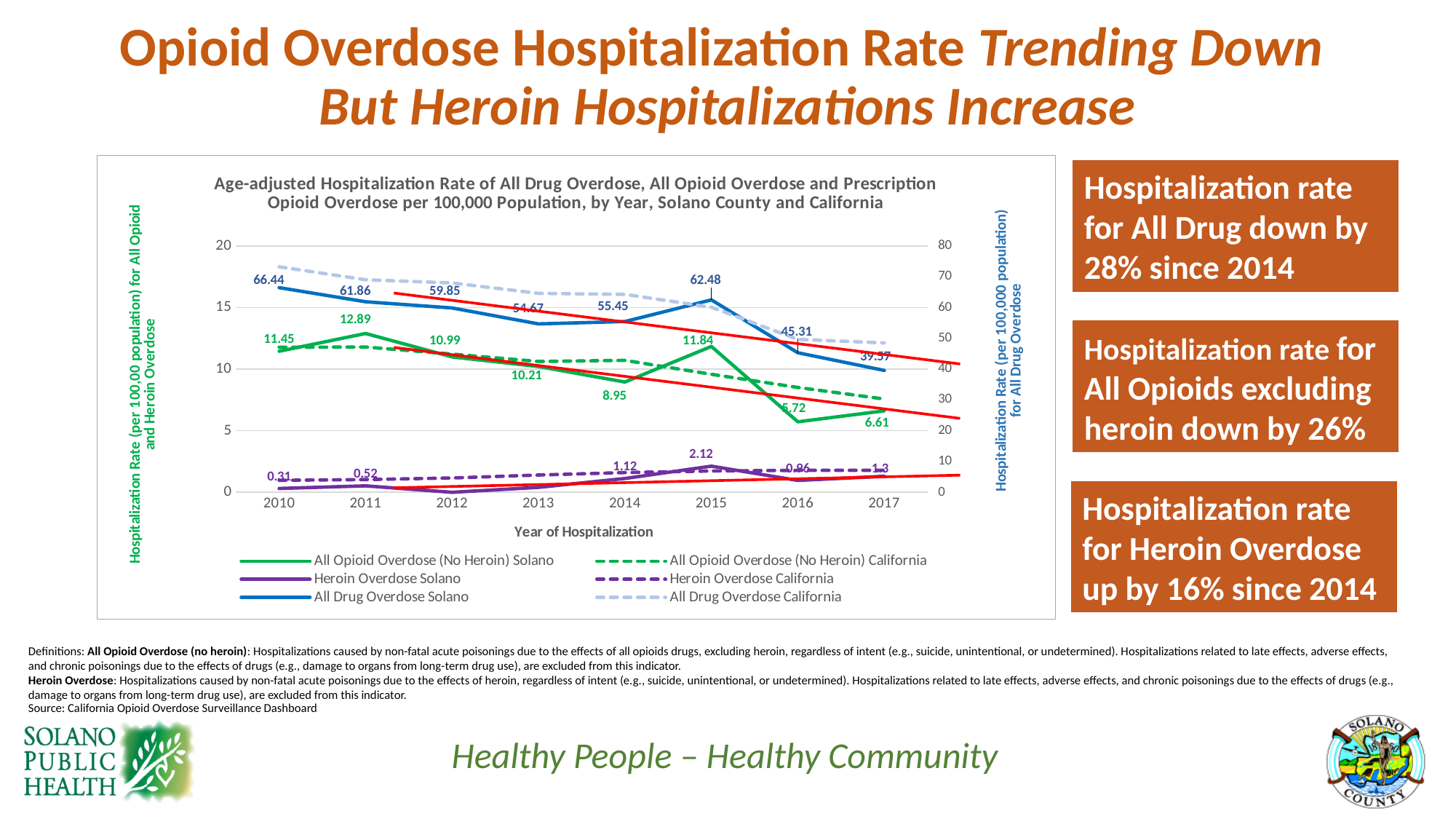
How many series does the chart legend list? 6 What is the difference between the All Drug Overdose Solano rate in 2010 and in 2017? 26.87 What kind of chart is shown on the slide? Line chart How many years are shown on the x axis of the chart? 8 Which year had the higher All Opioid Overdose (No Heroin) Solano rate, 2014 or 2015? 2015 What was the Heroin Overdose Solano rate in 2015? 2.12 What was the All Opioid Overdose (No Heroin) Solano rate in 2011? 12.89 What is the title of the x axis of the chart? Year of Hospitalization In which year was the All Opioid Overdose (No Heroin) Solano rate highest? 2011 What was the All Drug Overdose Solano hospitalization rate in 2010? 66.44 In which year was the All Drug Overdose Solano rate lowest? 2017 Does the All Drug Overdose Solano rate rise or fall from 2010 to 2017? Fall